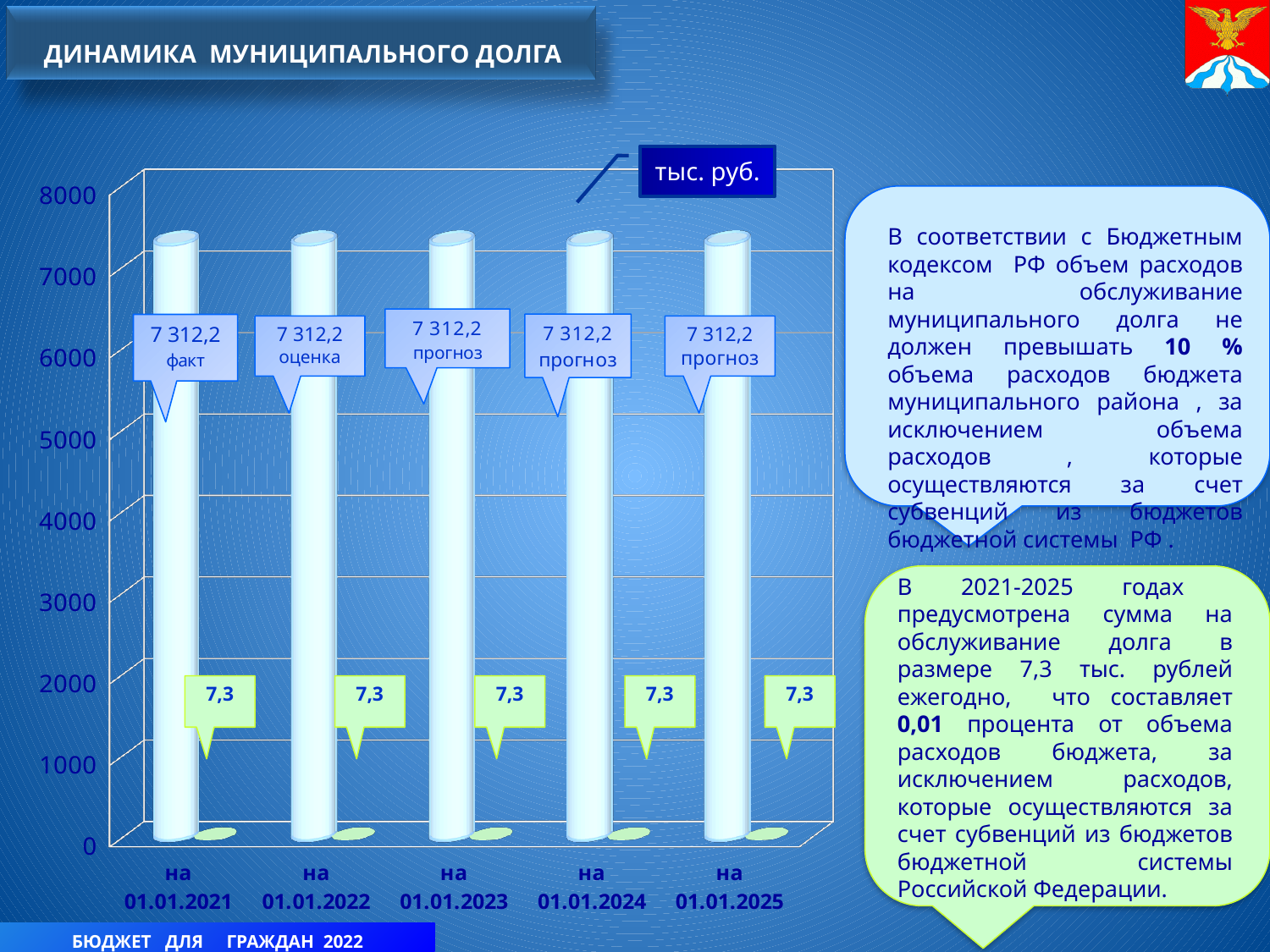
What is the debt servicing amount shown in the green label for 01.01.2023? 7,3 Is the municipal debt on 01.01.2023 greater or less than 8000? less What unit of measurement is indicated for the chart? тыс. руб. What is the title of the chart on the slide? ДИНАМИКА МУНИЦИПАЛЬНОГО ДОЛГА Is the municipal debt on 01.01.2022 greater or less than 7000? greater What is the value of municipal debt on 01.01.2025 according to the chart? 7 312,2 What is the difference between the municipal debt on 01.01.2024 and on 01.01.2022? 0 What kind of chart is shown on the slide? bar chart How many dates (categories) are shown on the x axis of the chart? 5 Do the municipal debt values rise, fall or stay the same from 01.01.2021 to 01.01.2025? stay the same What is the value of municipal debt on 01.01.2021 according to the chart? 7 312,2 Which of the two values is larger: the municipal debt on 01.01.2021 (7 312,2) or the debt servicing amount on 01.01.2021 (7,3)? 7 312,2